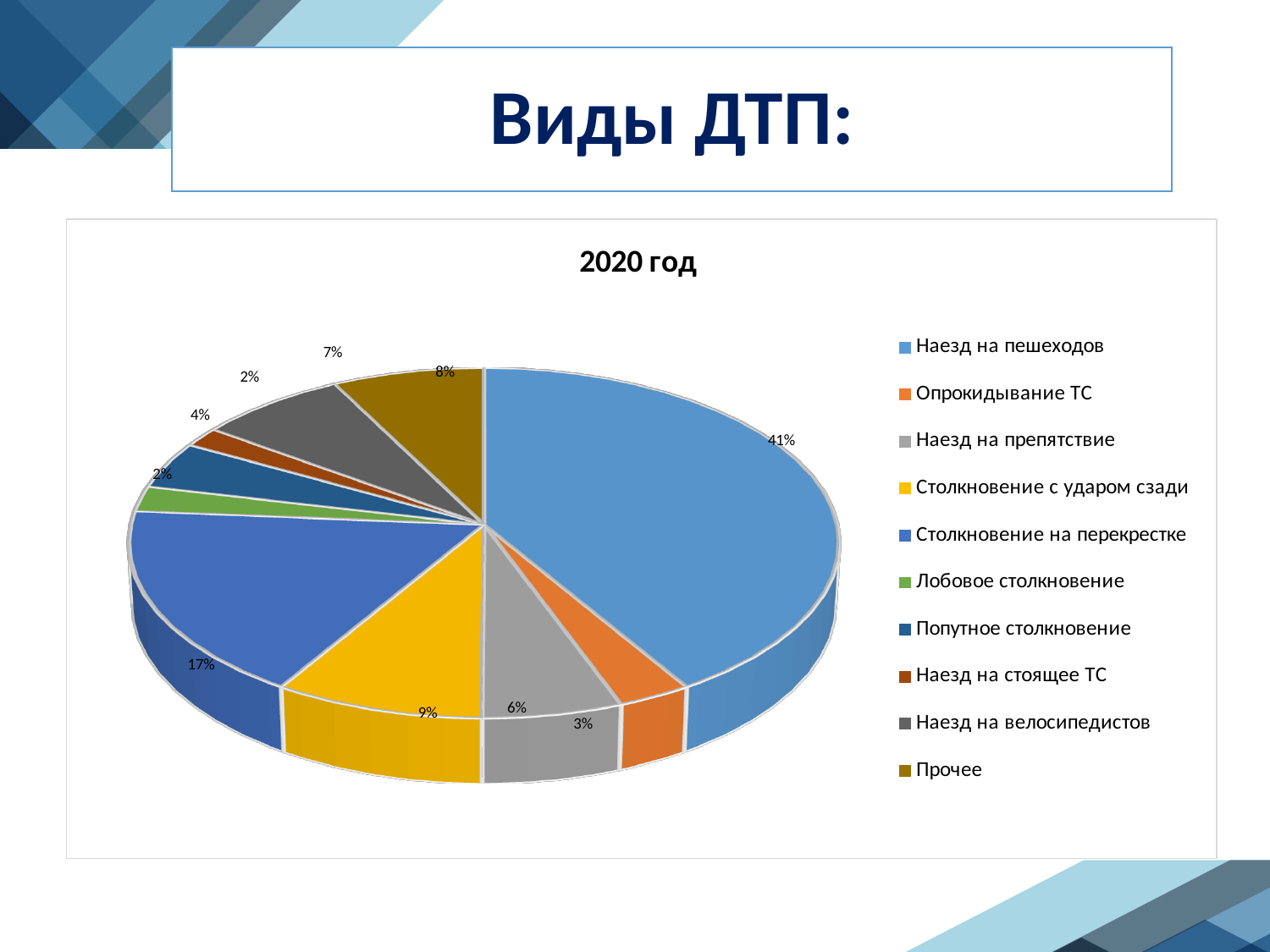
Which is larger, the share for "Наезд на препятствие" or the share for "Опрокидывание ТС"? Наезд на препятствие What is the difference between the shares of "Наезд на пешеходов" and "Столкновение на перекрестке"? 24% What share of the pie does "Столкновение на перекрестке" have? 17% Which category has the largest share of the pie? Наезд на пешеходов What is the value shown for "Наезд на велосипедистов"? 7% What share of the pie does "Наезд на пешеходов" have? 41% What is the value shown for "Прочее"? 8% How many categories does the legend of the pie chart list? 10 What colour is the slice for "Столкновение с ударом сзади"? yellow What is the title of the chart? 2020 год What is the value shown for "Столкновение с ударом сзади"? 9% What kind of chart is shown on the slide? pie chart